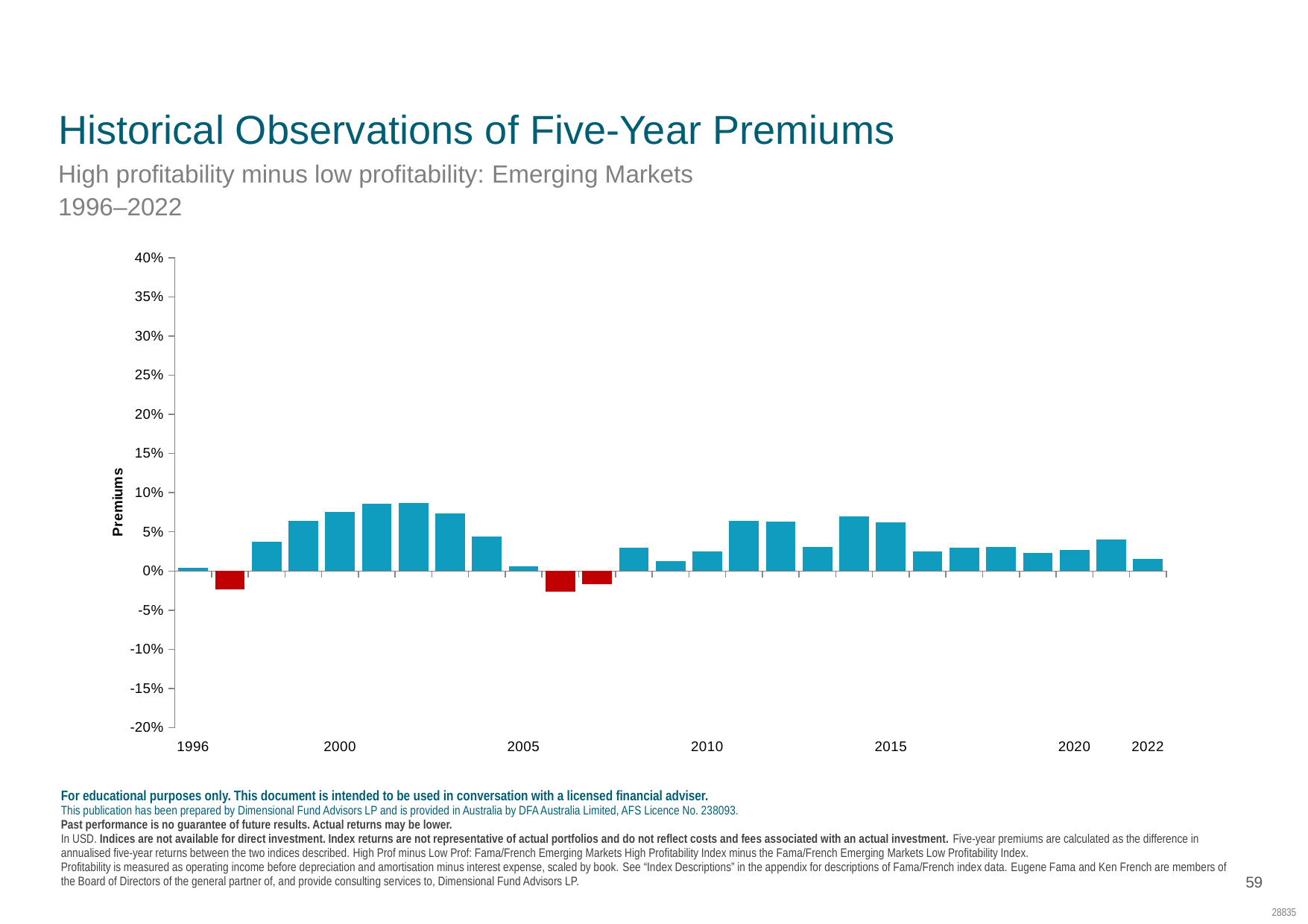
Which year has the lowest five-year premium in the chart? 2006 What kind of chart is shown on the slide? Bar chart Is the value for 2000 greater or less than 5%? greater Which year has the larger premium, 2011 or 2016? 2011 How many bars in the chart show a negative premium? 3 Is the value for 2009 greater or less than 5%? less What is the label on the vertical axis of the chart? Premiums Which year has the larger premium, 2000 or 2010? 2000 Is the value for 2014 greater or less than 5%? greater How many years (bars) are plotted in the chart? 27 Do the premiums rise or fall from 1998 to 2002? Rise